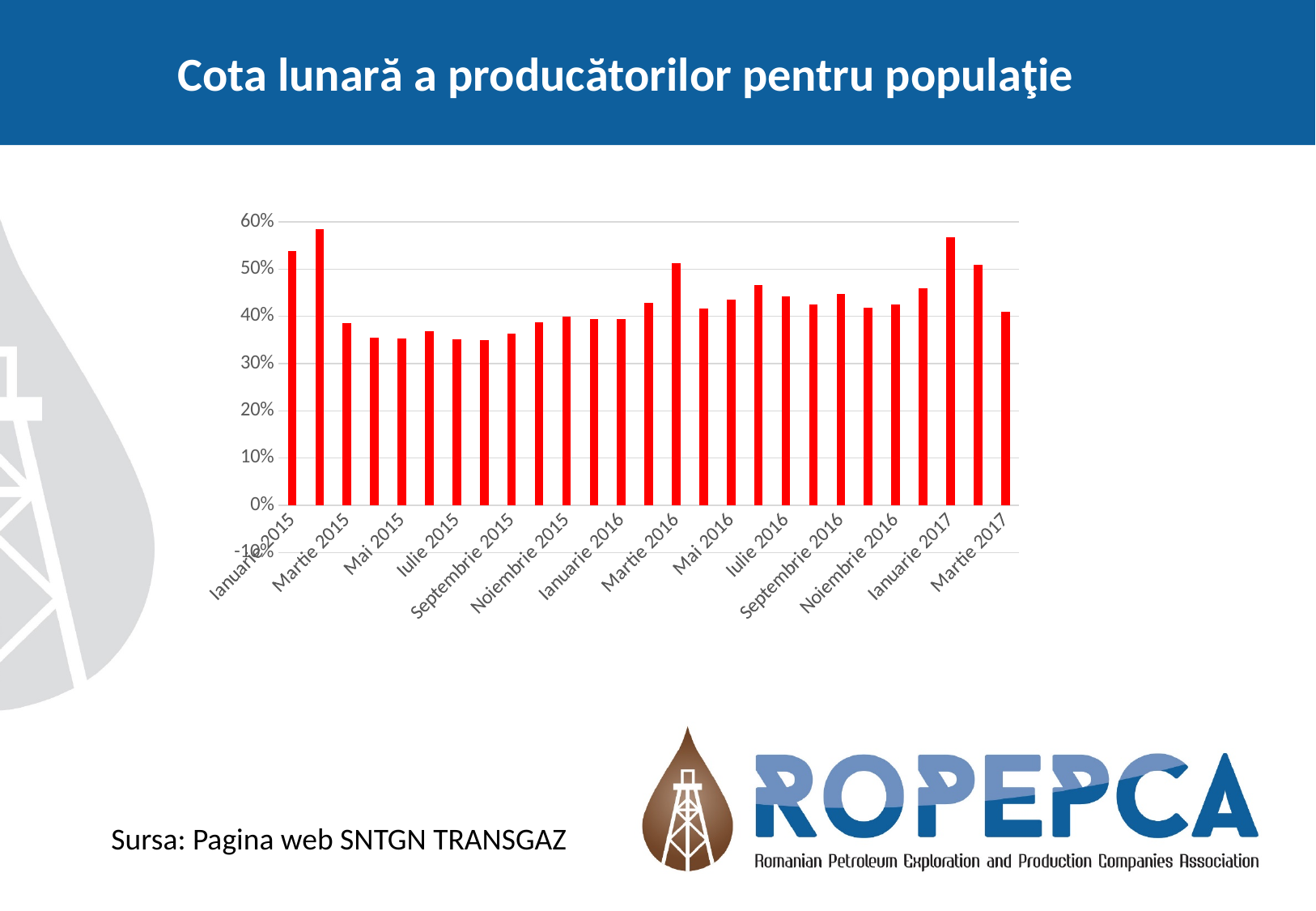
Which is larger, the value for Ianuarie 2017 or the value for Martie 2017? Ianuarie 2017 Is the value for Mai 2015 greater or less than 40%? less What colour are the bars in the chart? red Is the value for Martie 2015 greater or less than 40%? less Is the value for Ianuarie 2017 greater or less than 50%? greater Which is larger, the value for Ianuarie 2015 or the value for Martie 2015? Ianuarie 2015 What is the title of the slide's chart? Cota lunară a producătorilor pentru populaţie Which is larger, the value for Martie 2016 or the value for Mai 2016? Martie 2016 What kind of chart is shown on the slide? bar chart